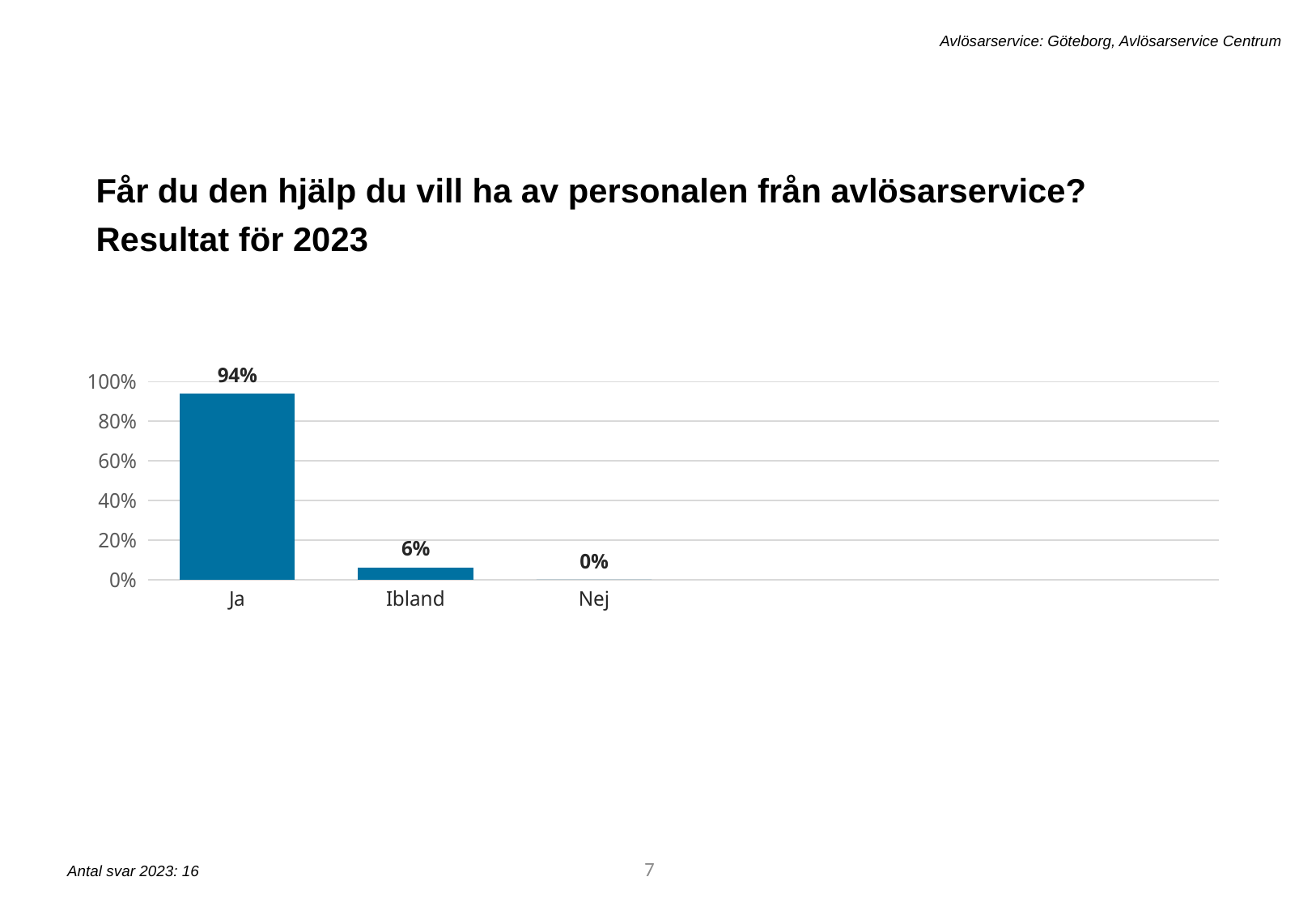
How many responses (Antal svar) does the slide report for 2023? 16 How many categories are shown on the x axis? 3 What is the difference between the values for Ja and Ibland? 88% Which is larger, the value for Ibland or the value for Nej? Ibland What is the value for Ja? 94% What is the value for Ibland? 6% Which category has the highest value? Ja What is the value for Nej? 0% Which category has the lowest value? Nej What kind of chart is shown on the slide? bar chart Is the value for Ja greater or less than 80%? greater Is the value for Ibland greater or less than 20%? less